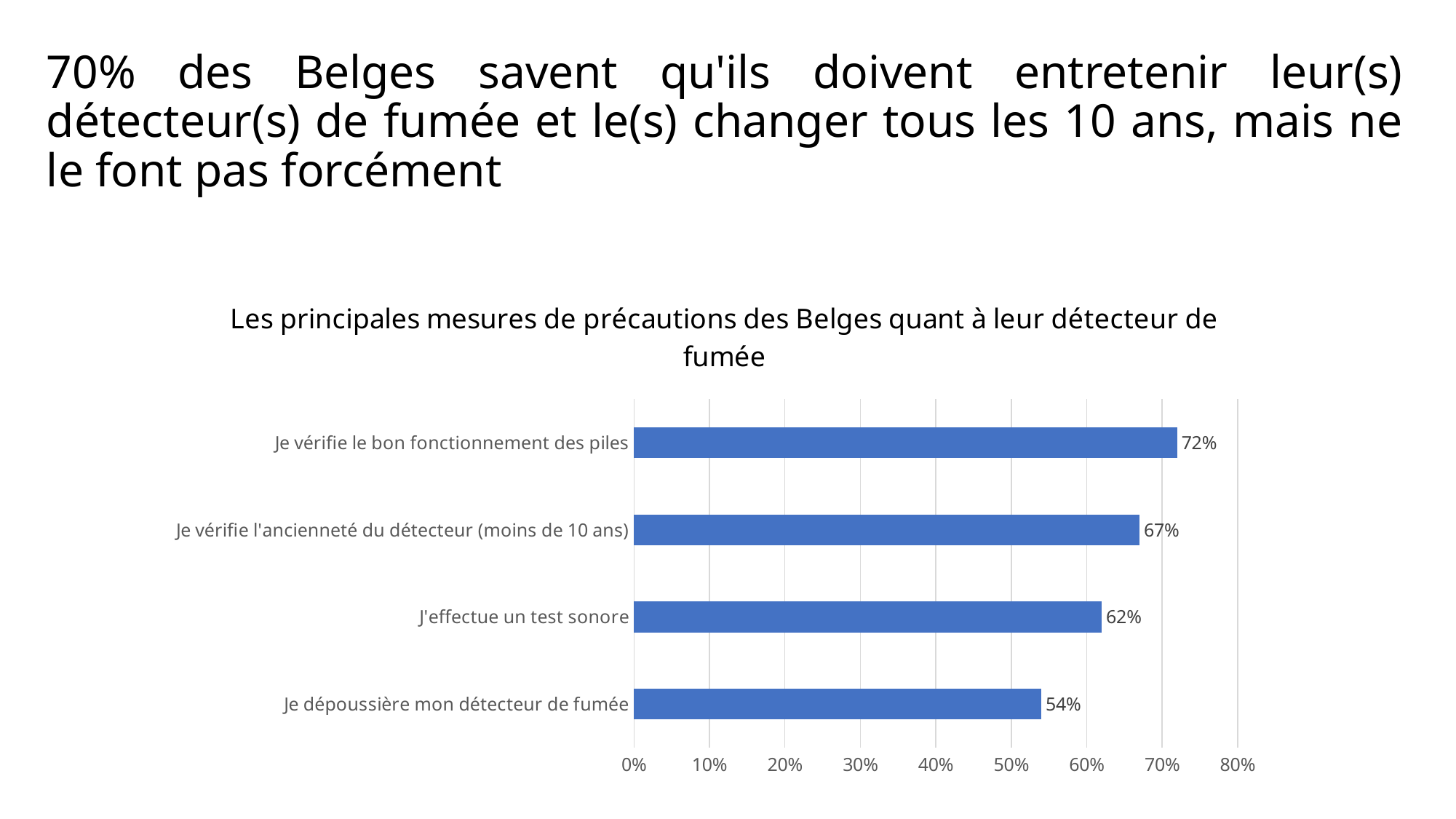
What is the difference between the values for "Je vérifie le bon fonctionnement des piles" and "Je dépoussière mon détecteur de fumée"? 18% What is the value for "J'effectue un test sonore"? 62% What is the title of the chart? Les principales mesures de précautions des Belges quant à leur détecteur de fumée Which category has the lowest value? Je dépoussière mon détecteur de fumée What is the difference between the values for "Je vérifie l'ancienneté du détecteur (moins de 10 ans)" and "J'effectue un test sonore"? 5% What is the value for "Je vérifie le bon fonctionnement des piles"? 72% How many categories are shown in the chart? 4 What kind of chart is shown on the slide? Bar chart What is the value for "Je dépoussière mon détecteur de fumée"? 54% Which is larger: the value for "J'effectue un test sonore" or the value for "Je dépoussière mon détecteur de fumée"? J'effectue un test sonore What is the value for "Je vérifie l'ancienneté du détecteur (moins de 10 ans)"? 67% Which category has the highest value? Je vérifie le bon fonctionnement des piles